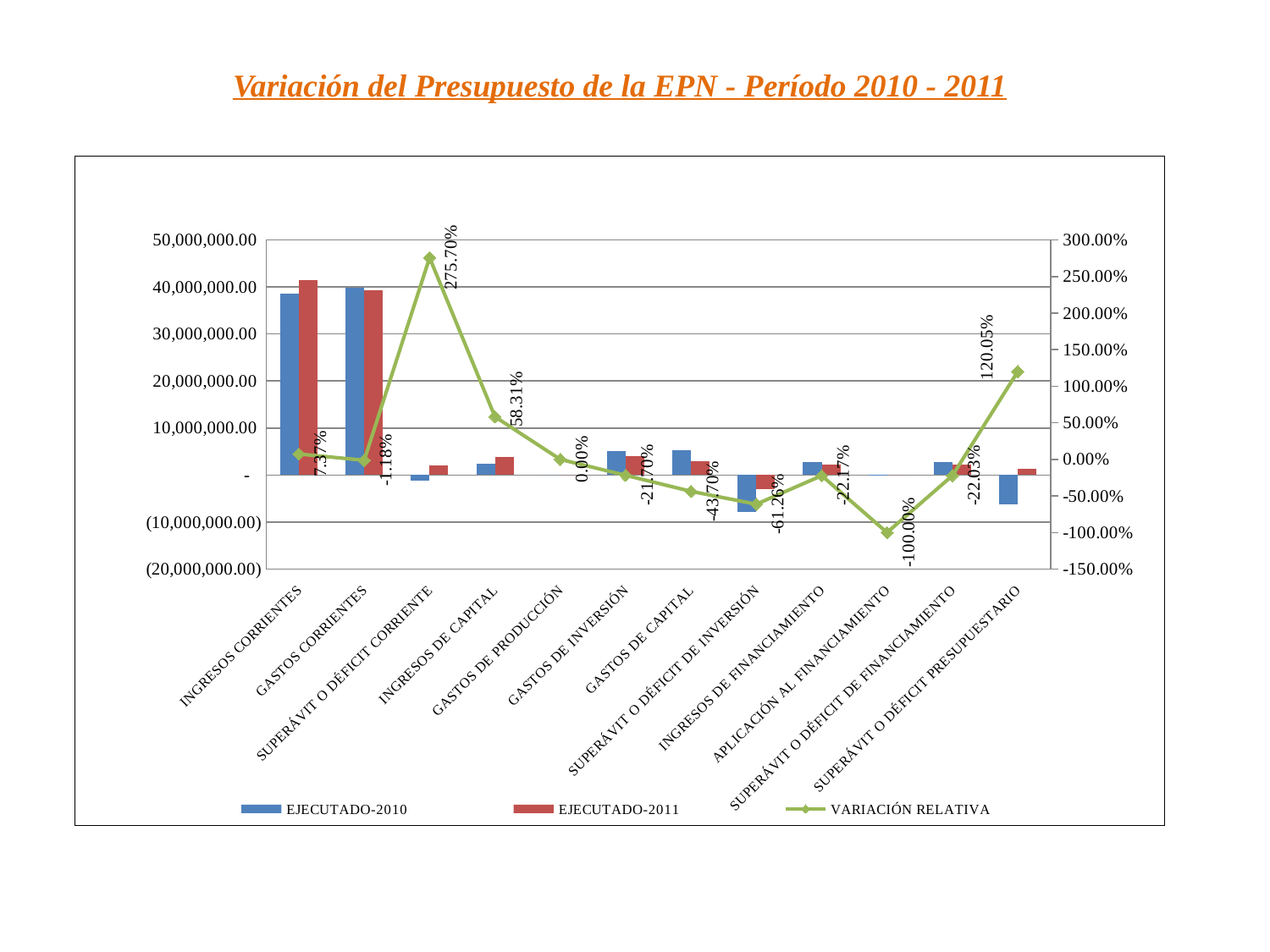
What is the VARIACIÓN RELATIVA value for SUPERÁVIT O DÉFICIT PRESUPUESTARIO? 120.05% What is the VARIACIÓN RELATIVA value for INGRESOS DE CAPITAL? 58.31% What is the difference between the VARIACIÓN RELATIVA values for SUPERÁVIT O DÉFICIT CORRIENTE and SUPERÁVIT O DÉFICIT PRESUPUESTARIO? 155.65% What is the title of the slide? Variación del Presupuesto de la EPN - Período 2010 - 2011 How many series does the legend list? 3 Which category has the lowest VARIACIÓN RELATIVA value? APLICACIÓN AL FINANCIAMIENTO Which has a larger VARIACIÓN RELATIVA value, GASTOS DE CAPITAL or SUPERÁVIT O DÉFICIT DE INVERSIÓN? GASTOS DE CAPITAL What is the VARIACIÓN RELATIVA value for SUPERÁVIT O DÉFICIT CORRIENTE? 275.70% What is the VARIACIÓN RELATIVA value for APLICACIÓN AL FINANCIAMIENTO? -100.00% Which category has the highest VARIACIÓN RELATIVA value? SUPERÁVIT O DÉFICIT CORRIENTE Is the EJECUTADO-2011 value for INGRESOS CORRIENTES greater or less than 40,000,000.00? greater How many categories are shown on the x axis? 12